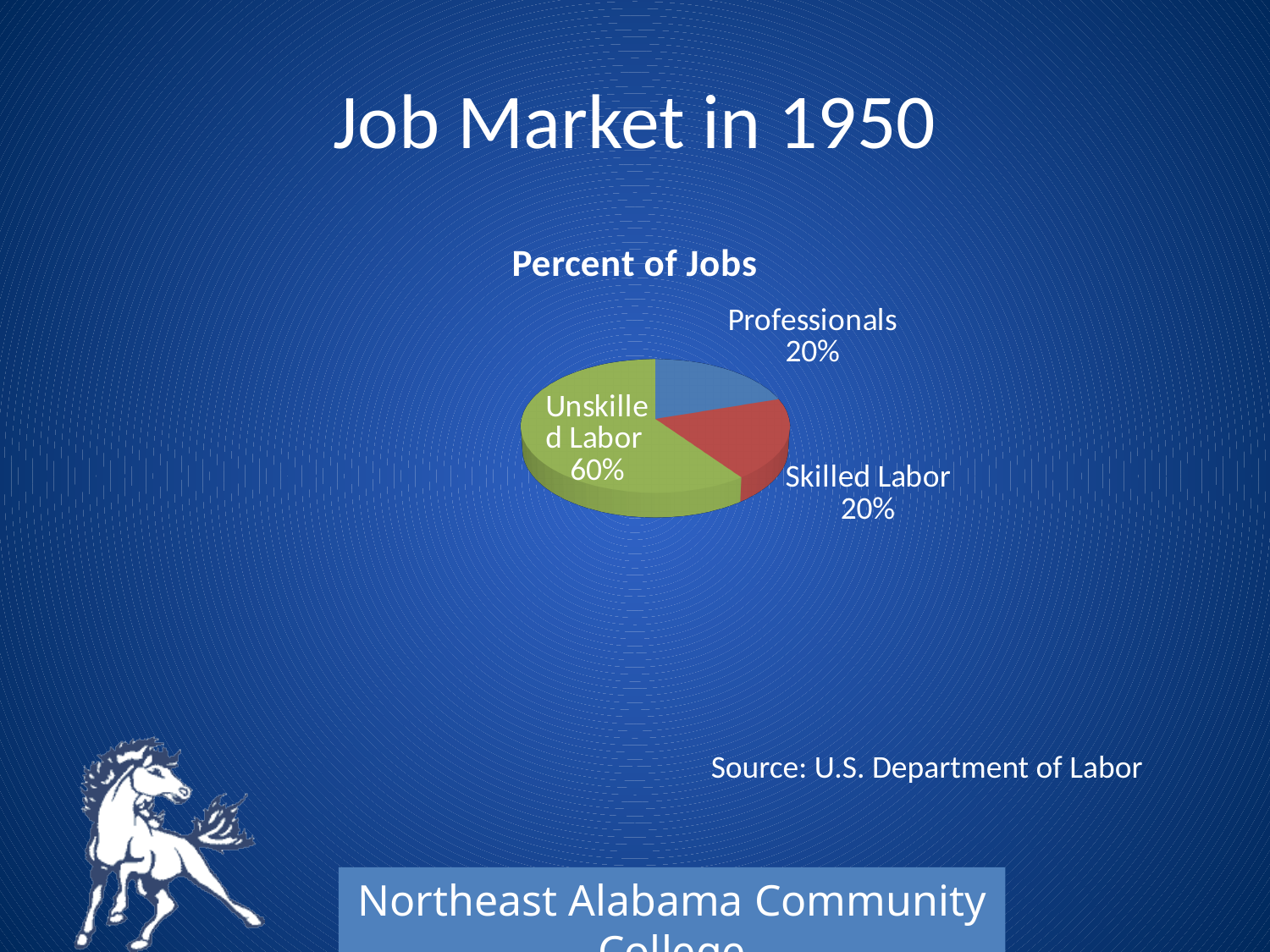
What is the combined share of Professionals and Skilled Labor? 40% What is the difference between the Unskilled Labor share and the Professionals share? 40% What percentage of jobs is Skilled Labor? 20% What percentage of jobs is Unskilled Labor? 60% How many slices does the pie chart have? 3 What is the title of the chart? Percent of Jobs Which is larger, the Unskilled Labor share or the Skilled Labor share? Unskilled Labor What is the source cited for the chart data? U.S. Department of Labor Which category has the largest share of the pie? Unskilled Labor What percentage of jobs is Professionals? 20% What kind of chart is shown on the slide? pie chart What colour is the Unskilled Labor slice? green